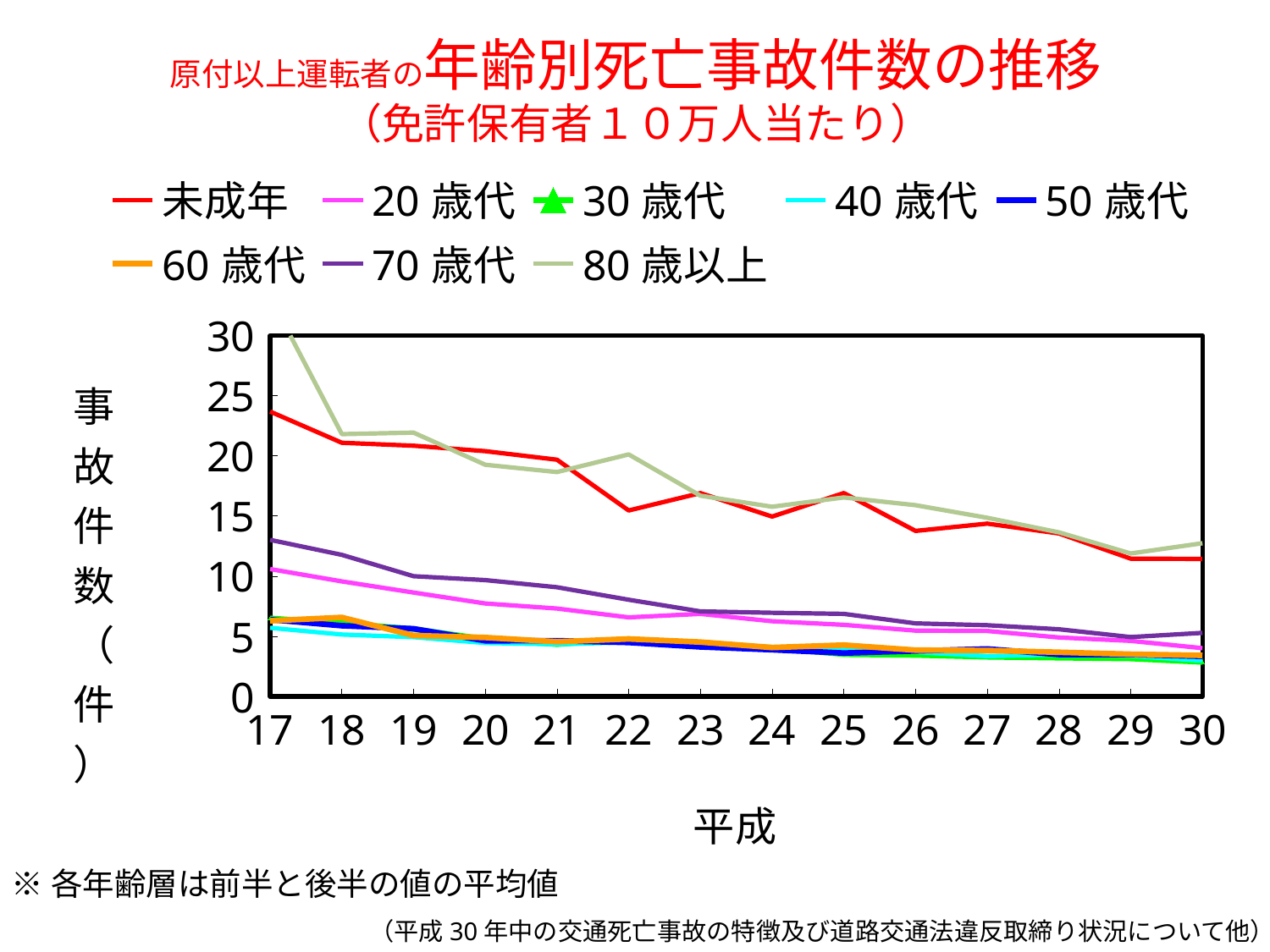
Does the value for 80歳以上 rise or fall from 平成17 to 平成30? fall How many series does the legend list? 8 Which series has the highest value in 平成17? 80歳以上 In 平成22, which is larger, the value for 未成年 or the value for 80歳以上? 80歳以上 Is the value for 20歳代 in 平成30 greater or less than 5? less Is the value for 80歳以上 in 平成17 greater or less than 25? greater What kind of chart is shown on the slide? line chart Is the value for 未成年 in 平成30 greater or less than 15? less Does the value for 未成年 rise or fall from 平成17 to 平成30? fall What is the label of the x axis? 平成 How many years (points) are shown along the x axis? 14